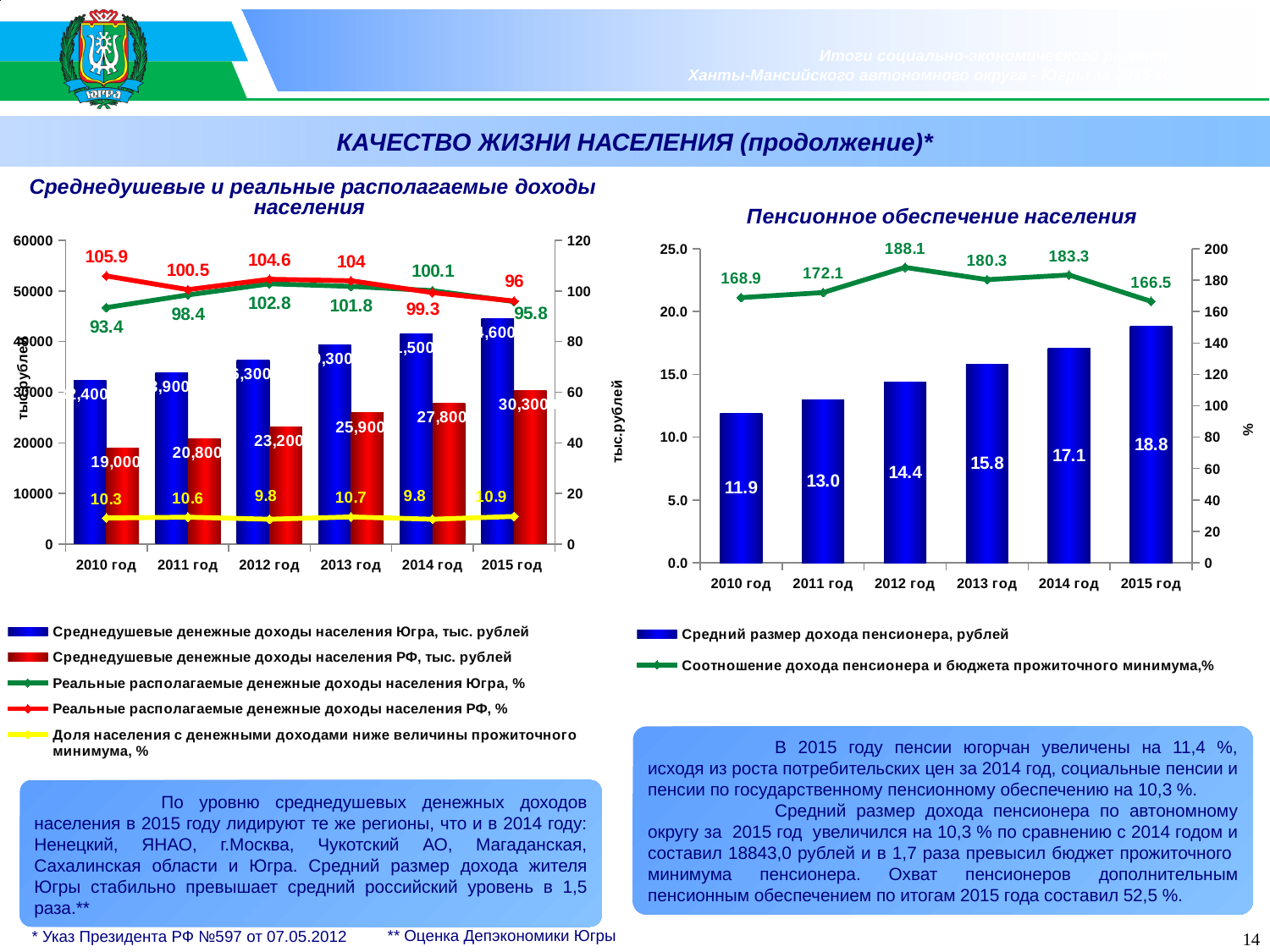
In the chart 'Пенсионное обеспечение населения', what is the average pensioner income (Средний размер дохода пенсионера) for 2015 год? 18.8 In the chart 'Среднедушевые и реальные располагаемые доходы населения', what is the value of Доля населения с денежными доходами ниже величины прожиточного минимума for 2015 год? 10.9 In the chart 'Среднедушевые и реальные располагаемые доходы населения', in which year is Реальные располагаемые денежные доходы населения РФ highest? 2010 год In the chart 'Среднедушевые и реальные располагаемые доходы населения', what is the value of Среднедушевые денежные доходы населения РФ for 2015 год? 30,300 In the chart 'Пенсионное обеспечение населения', in which year is the ratio of pensioner income to the subsistence minimum (Соотношение дохода пенсионера и бюджета прожиточного минимума) highest? 2012 год How many years are shown on the x axis of the chart 'Пенсионное обеспечение населения'? 6 In the chart 'Пенсионное обеспечение населения', in which year is the ratio of pensioner income to the subsistence minimum lowest? 2015 год In the chart 'Среднедушевые и реальные располагаемые доходы населения', what is the value of Реальные располагаемые денежные доходы населения Югра for 2012 год? 102.8 How many series does the legend of the chart 'Пенсионное обеспечение населения' list? 2 In the chart 'Пенсионное обеспечение населения', do the bars for average pensioner income rise or fall from 2010 год to 2015 год? rise In the chart 'Пенсионное обеспечение населения', by how much did the average pensioner income increase from 2010 год to 2015 год? 6.9 In the chart 'Среднедушевые и реальные располагаемые доходы населения', for 2013 год, which is larger: Реальные располагаемые денежные доходы населения Югра or Реальные располагаемые денежные доходы населения РФ? Реальные располагаемые денежные доходы населения РФ